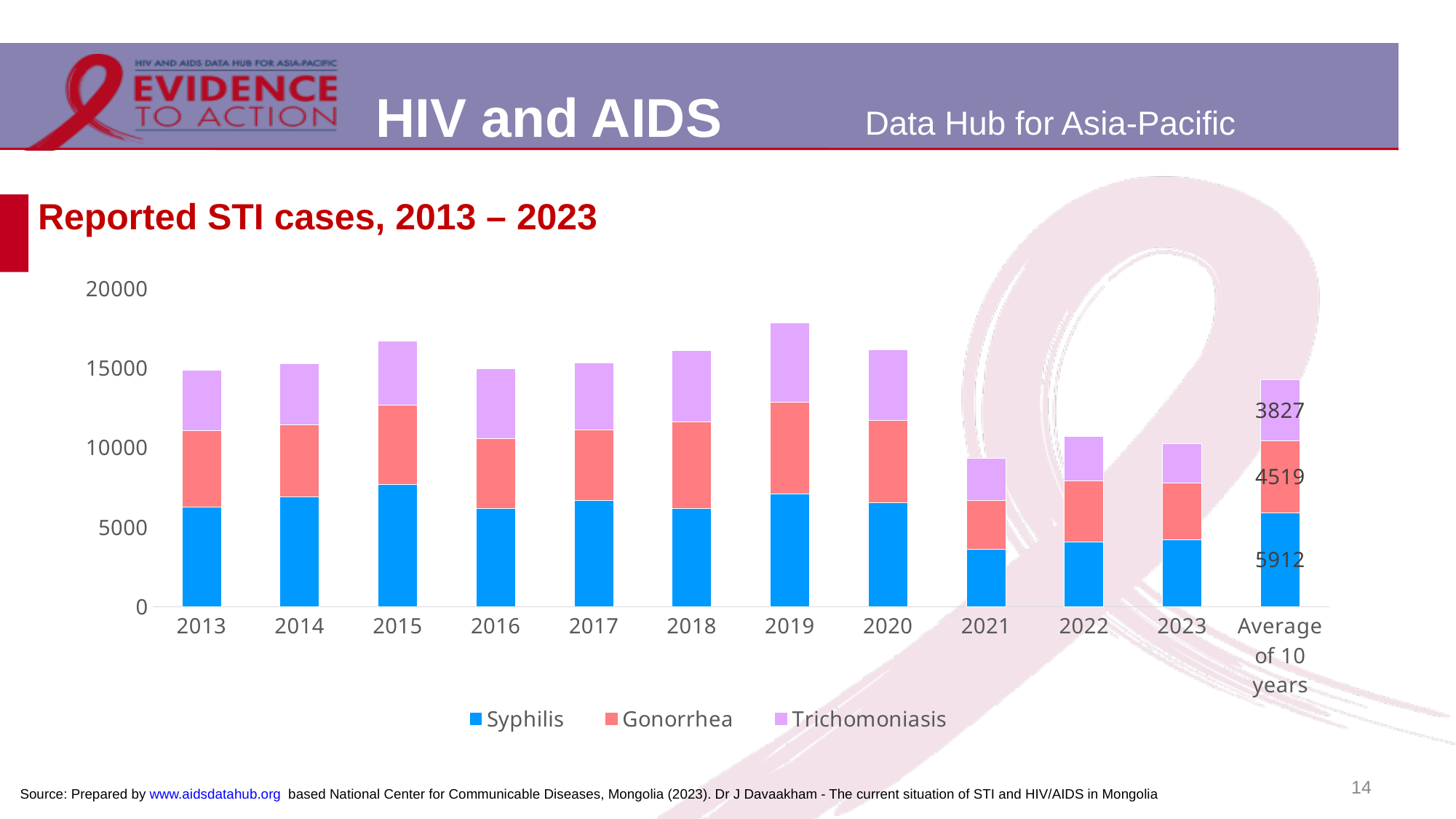
Which year has the highest total of reported STI cases? 2019 Which year has the lowest total of reported STI cases? 2021 What is the Gonorrhea value for the 'Average of 10 years' bar? 4519 What kind of chart is shown on the slide? Stacked bar chart What is the difference between the Syphilis and Gonorrhea values in the 'Average of 10 years' bar? 1393 How many categories are shown along the x axis? 12 Is the total value for 2021 greater or less than 10000? less What is the total of the 'Average of 10 years' stacked bar? 14258 What is the Trichomoniasis value for the 'Average of 10 years' bar? 3827 What is the Syphilis value for the 'Average of 10 years' bar? 5912 What is the title of the chart? Reported STI cases, 2013 – 2023 How many series does the legend list? 3